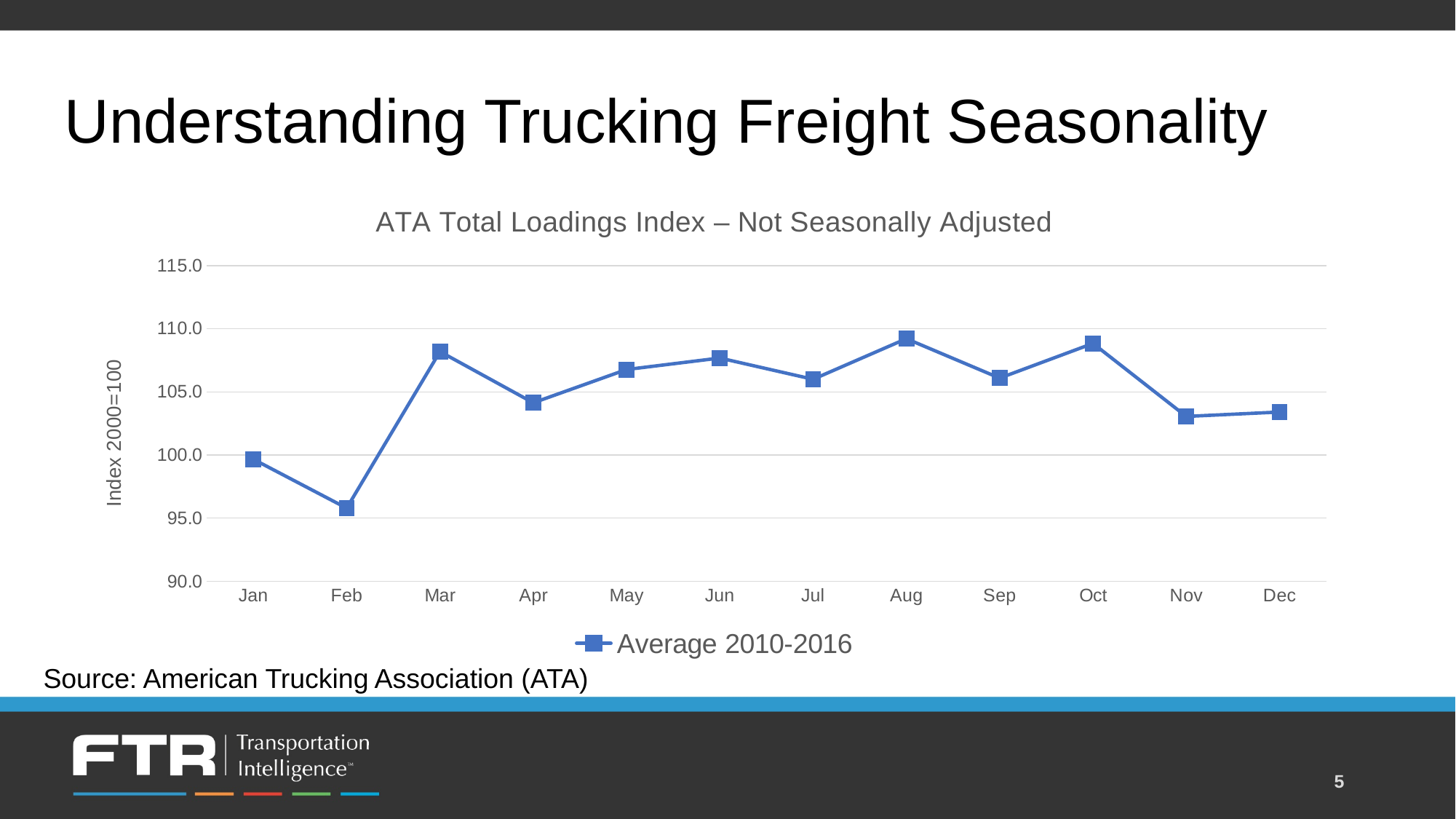
Which month has the lowest value? Feb How many months are plotted on the x axis? 12 What series name does the legend show? Average 2010-2016 How many series does the legend list? 1 Is the value for Nov greater or less than 105.0? less Is the value for Aug greater or less than 105.0? greater Is the value for Mar greater or less than 105.0? greater Which is larger, the value for Mar or the value for Apr? Mar What kind of chart is shown on the slide? line chart Does the value rise or fall from Oct to Nov? fall What is the title of the chart? ATA Total Loadings Index – Not Seasonally Adjusted